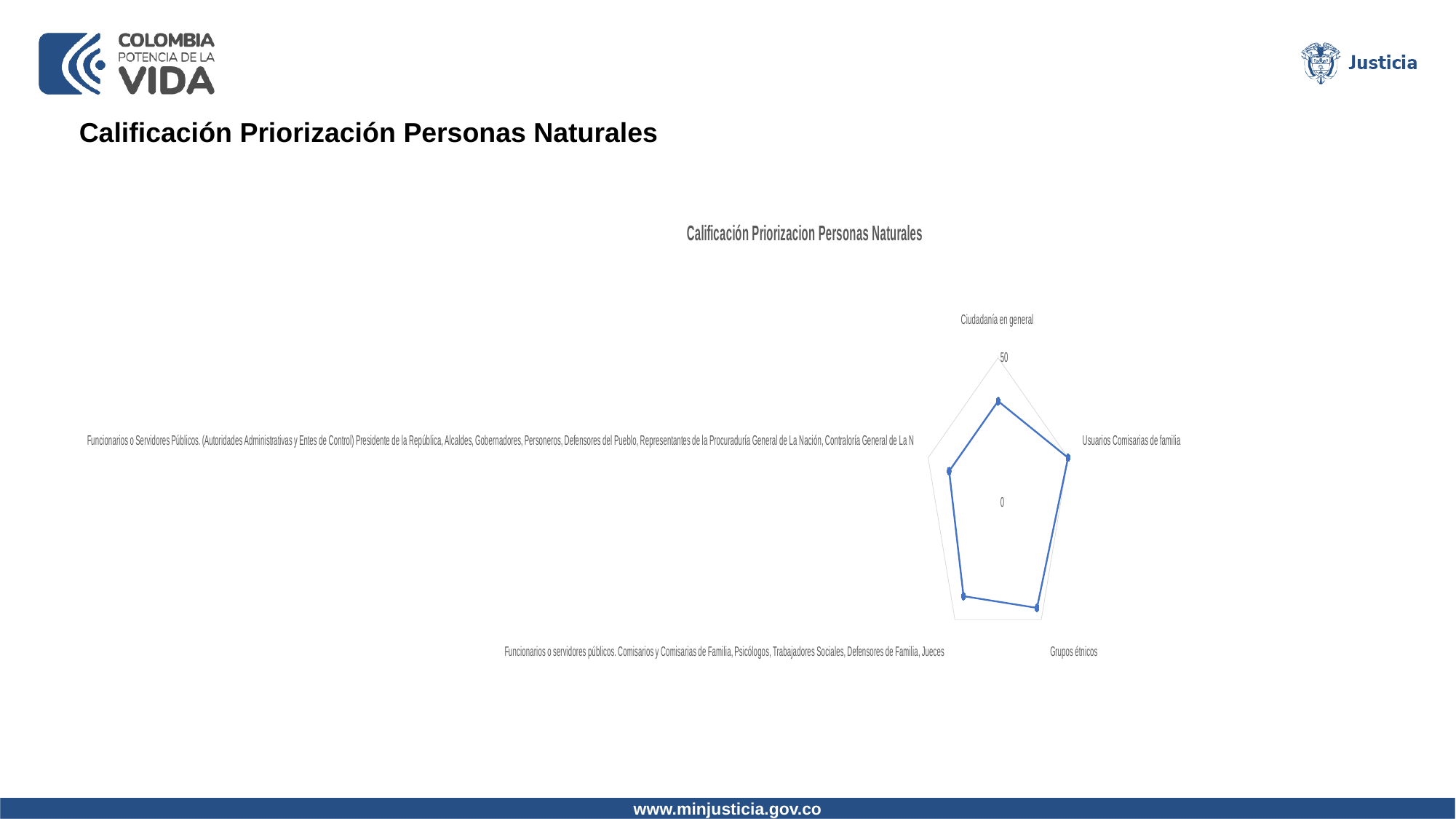
Is the value for Grupos étnicos greater or less than 0? greater What is the title of the chart? Calificación Priorizacion Personas Naturales Is the value for Ciudadanía en general greater or less than 50? less What kind of chart is shown on the slide? radar chart Which has the larger value, Grupos étnicos or Ciudadanía en general? Grupos étnicos How many categories are plotted on the radar chart? 5 What is the maximum value shown on the chart's axis scale? 50 Which has the larger value, Usuarios Comisarias de familia or Ciudadanía en general? Usuarios Comisarias de familia Which has the larger value, Grupos étnicos or Funcionarios o Servidores Públicos (Autoridades Administrativas y Entes de Control)? Grupos étnicos